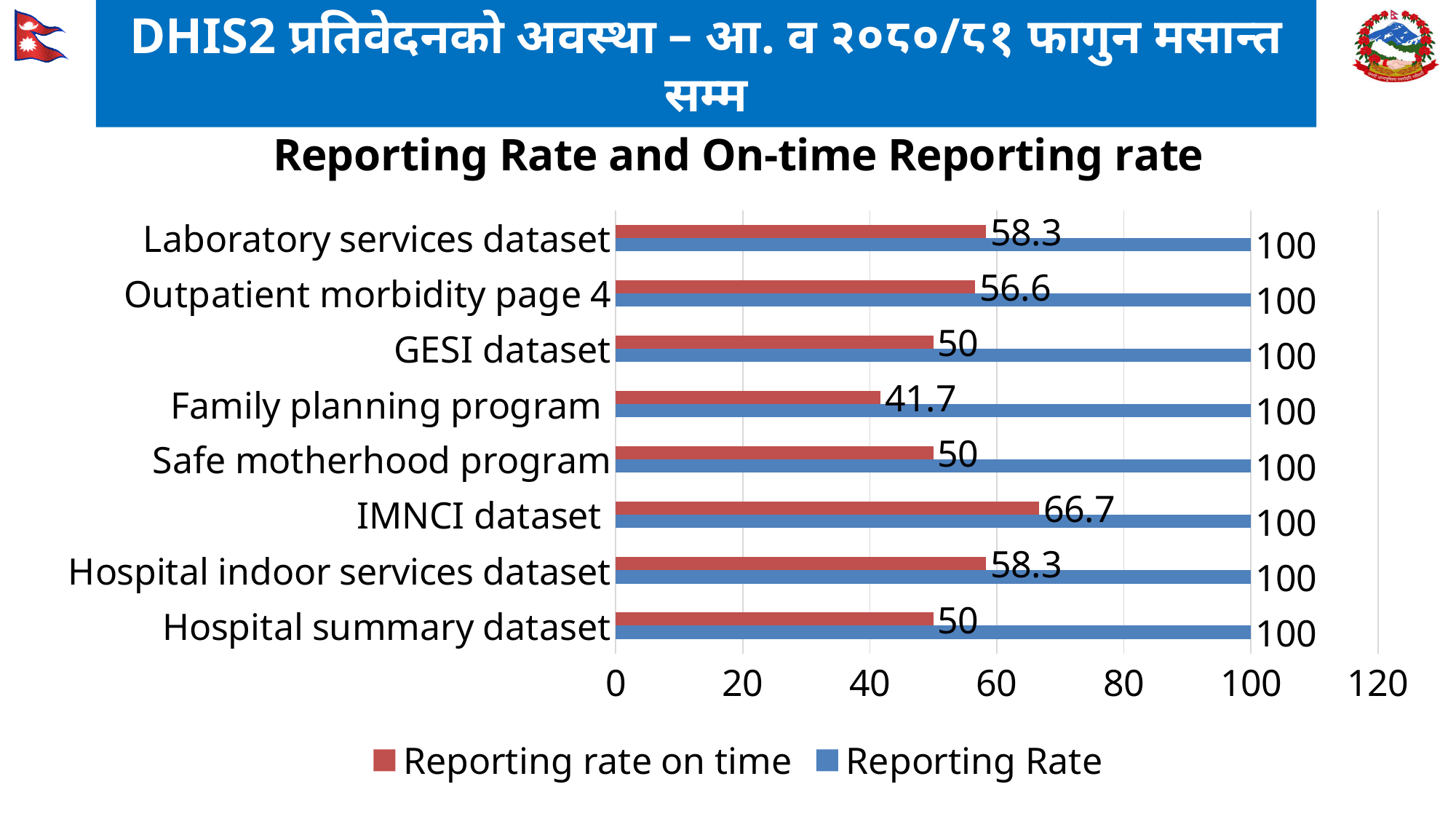
What is the title of the chart? Reporting Rate and On-time Reporting rate Which is larger, the Reporting rate on time for the IMNCI dataset or for the Hospital indoor services dataset? IMNCI dataset What is the Reporting Rate for the GESI dataset? 100 Which category has the lowest Reporting rate on time? Family planning program What is the Reporting rate on time for the Family planning program? 41.7 What is the Reporting rate on time for the IMNCI dataset? 66.7 What is the difference between the Reporting Rate and the Reporting rate on time for the Laboratory services dataset? 41.7 What is the Reporting rate on time for Outpatient morbidity page 4? 56.6 What kind of chart is shown on the slide? Bar chart Which category has the highest Reporting rate on time? IMNCI dataset How many series does the legend list? 2 How many categories are shown on the chart? 8